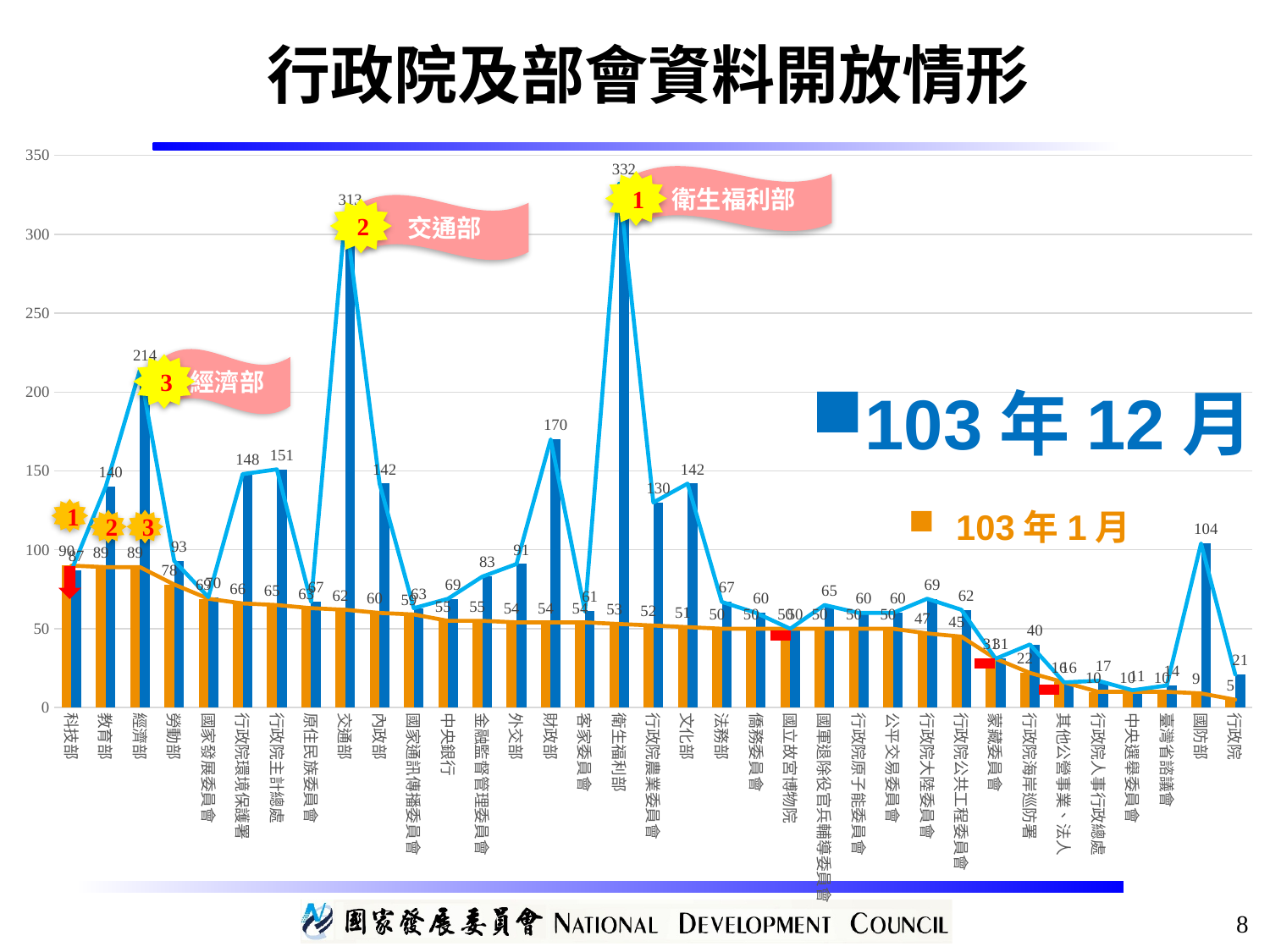
Which ministry has the highest 103年12月 value? 衛生福利部 What kind of chart is shown on the slide? bar chart with a line Is the 103年12月 value for 文化部 greater or less than 100? greater Which has the larger 103年12月 value, 財政部 or 教育部? 財政部 What is the 103年12月 value for 交通部? 313 Which ministry is marked with the number 1 callout on the chart? 衛生福利部 What is the difference between the 103年12月 values for 衛生福利部 and 交通部? 19 What is the 103年12月 value for 衛生福利部? 332 What is the 103年12月 value for 財政部? 170 For 經濟部, how much higher is the 103年12月 value than the 103年1月 value? 125 What is the 103年1月 value for 國防部? 9 How many series does the legend list? 2